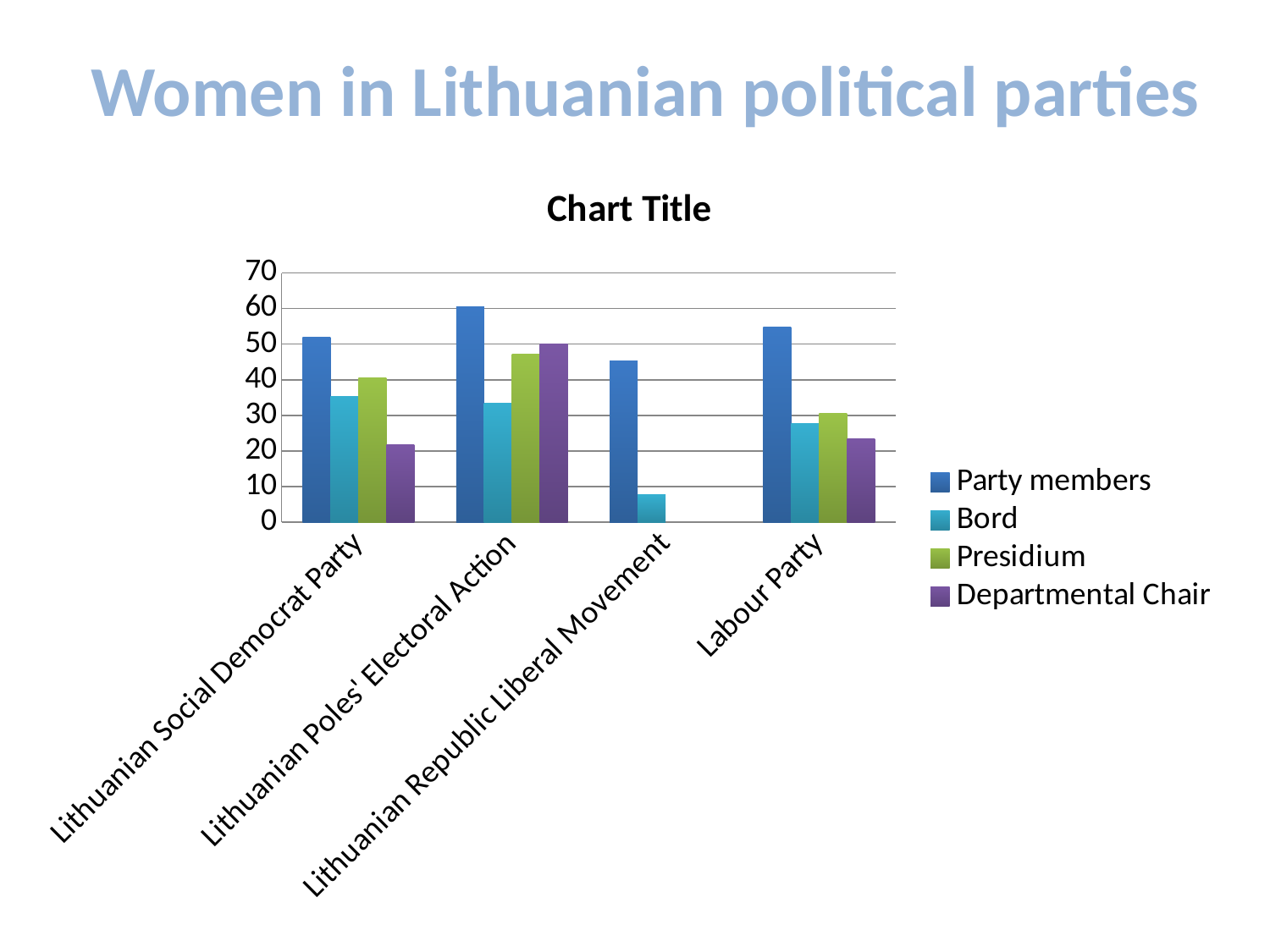
Is the Presidium value for Lithuanian Poles' Electoral Action greater or less than 40? greater Which party has the highest value for Departmental Chair? Lithuanian Poles' Electoral Action What is the title shown above the chart? Chart Title Which party has the highest value for Party members? Lithuanian Poles' Electoral Action Is the Departmental Chair value for Lithuanian Social Democrat Party greater or less than 30? less How many series does the legend list? 4 What kind of chart is shown on the slide? bar chart Is the Party members value for Lithuanian Poles' Electoral Action greater or less than 50? greater Which party has the lowest value for Bord? Lithuanian Republic Liberal Movement Which is larger, the Party members value for Lithuanian Social Democrat Party or for Lithuanian Republic Liberal Movement? Lithuanian Social Democrat Party How many political parties are shown on the x axis? 4